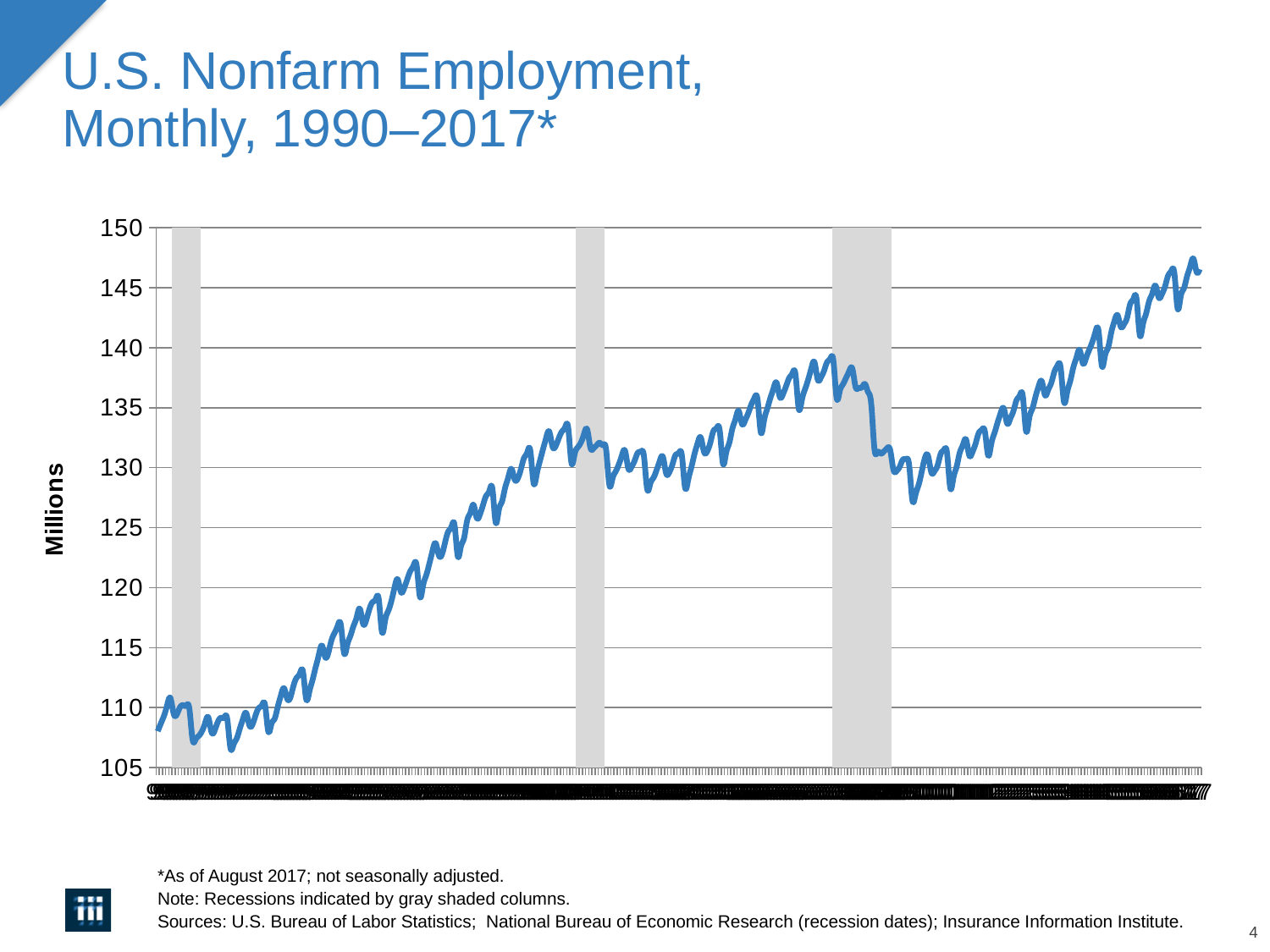
Is the highest value reached by the line greater or less than 145? greater Is the lowest value reached by the line greater or less than 110? less Is the highest value reached by the line greater or less than 150? less What do the gray shaded columns on the chart indicate? Recessions How many gray shaded recession columns are shown on the chart? 3 Overall, do the values rise or fall from left to right along the x axis? rise What is the title of the y axis? Millions What kind of chart is shown on the slide? line chart